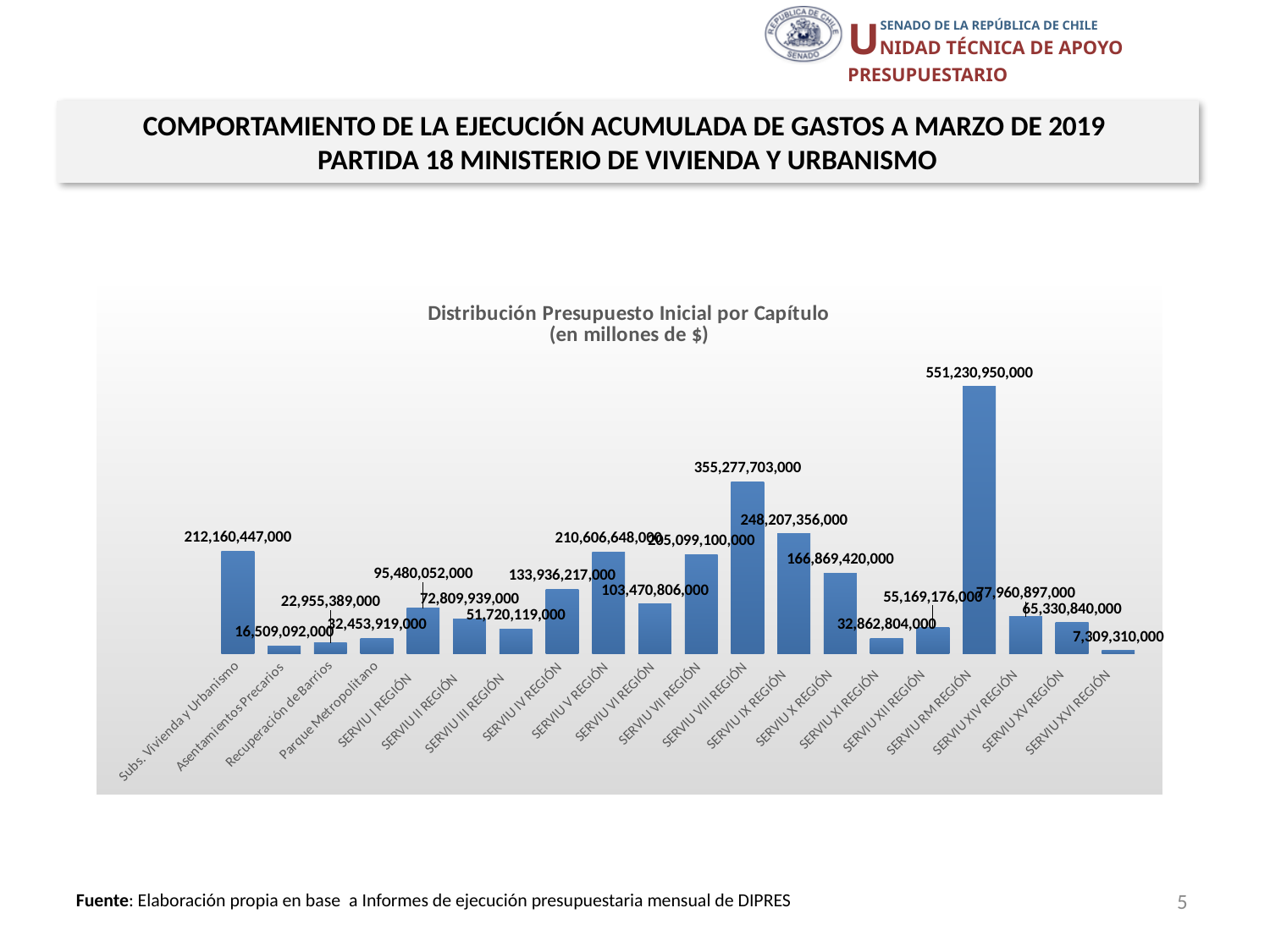
What is the value for Parque Metropolitano? 32,453,919,000 How many categories are shown on the x axis of the chart? 20 What is the value for SERVIU XVI REGIÓN? 7,309,310,000 What type of chart is shown on the slide? Bar chart What is the value for SERVIU VIII REGIÓN? 355,277,703,000 What is the value for SERVIU RM REGIÓN? 551,230,950,000 What is the difference between the values for SERVIU RM REGIÓN and SERVIU VIII REGIÓN? 195,953,247,000 Which is larger, the value for SERVIU IX REGIÓN or the value for SERVIU X REGIÓN? SERVIU IX REGIÓN Which category has the highest value in the chart? SERVIU RM REGIÓN What is the title of the chart? Distribución Presupuesto Inicial por Capítulo (en millones de $) What is the value for Subs. Vivienda y Urbanismo? 212,160,447,000 Which category has the lowest value in the chart? SERVIU XVI REGIÓN